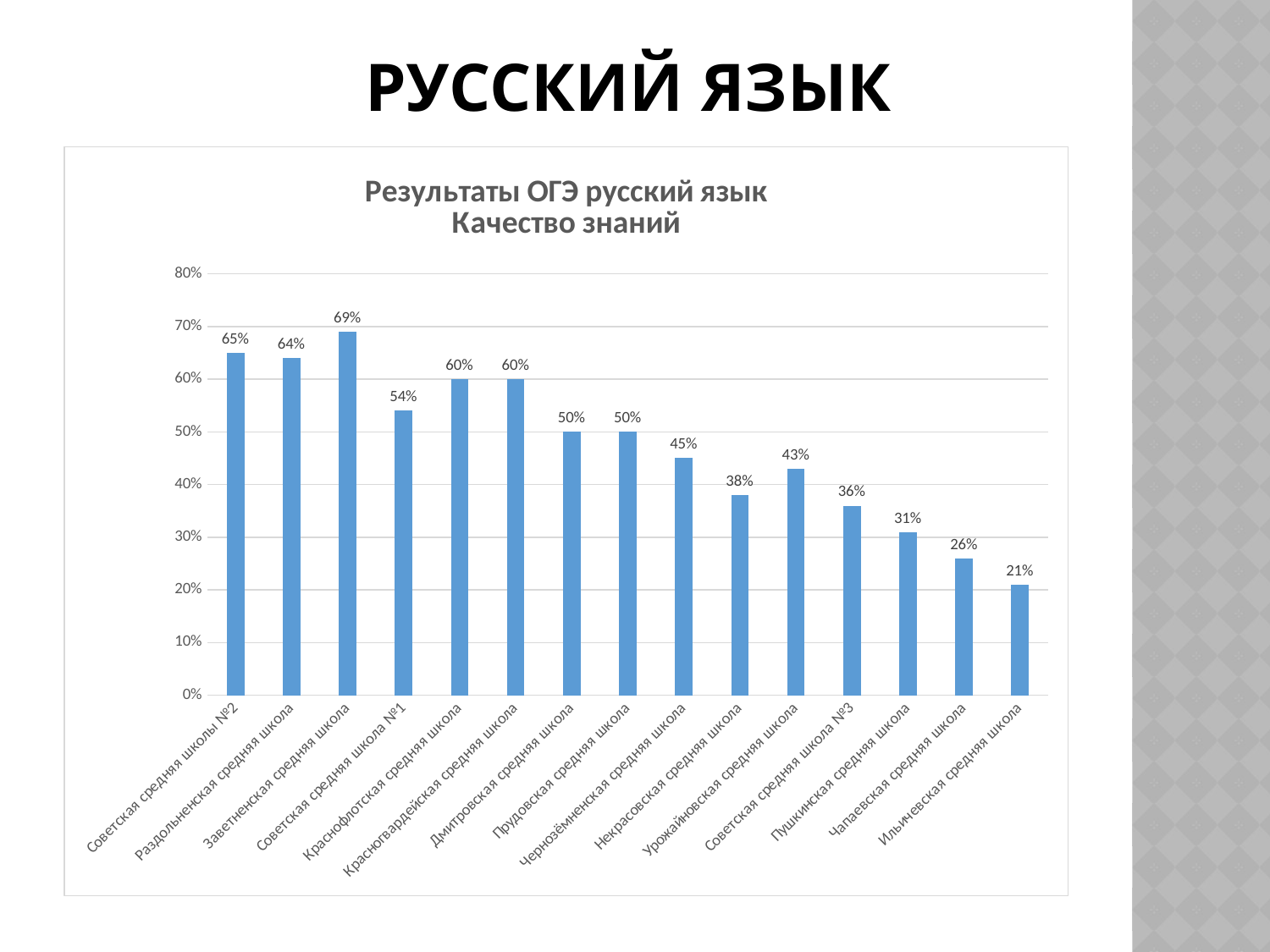
Which is larger, the value for Урожайновская средняя школа or Некрасовская средняя школа? Урожайновская средняя школа What kind of chart is shown on the slide? bar chart Which school has the lowest value? Ильичевская средняя школа What is the value for Пушкинская средняя школа? 31% What is the title of the chart? Результаты ОГЭ русский язык Качество знаний What is the value for Заветненская средняя школа? 69% What is the difference between the values for Советская средняя школа №1 and Советская средняя школа №3? 18% Which school has the highest value? Заветненская средняя школа What is the value for Некрасовская средняя школа? 38% How many schools are shown in the chart? 15 Is the value for Чапаевская средняя школа greater or less than 30%? less What is the difference between the values for Заветненская средняя школа and Ильичевская средняя школа? 48%